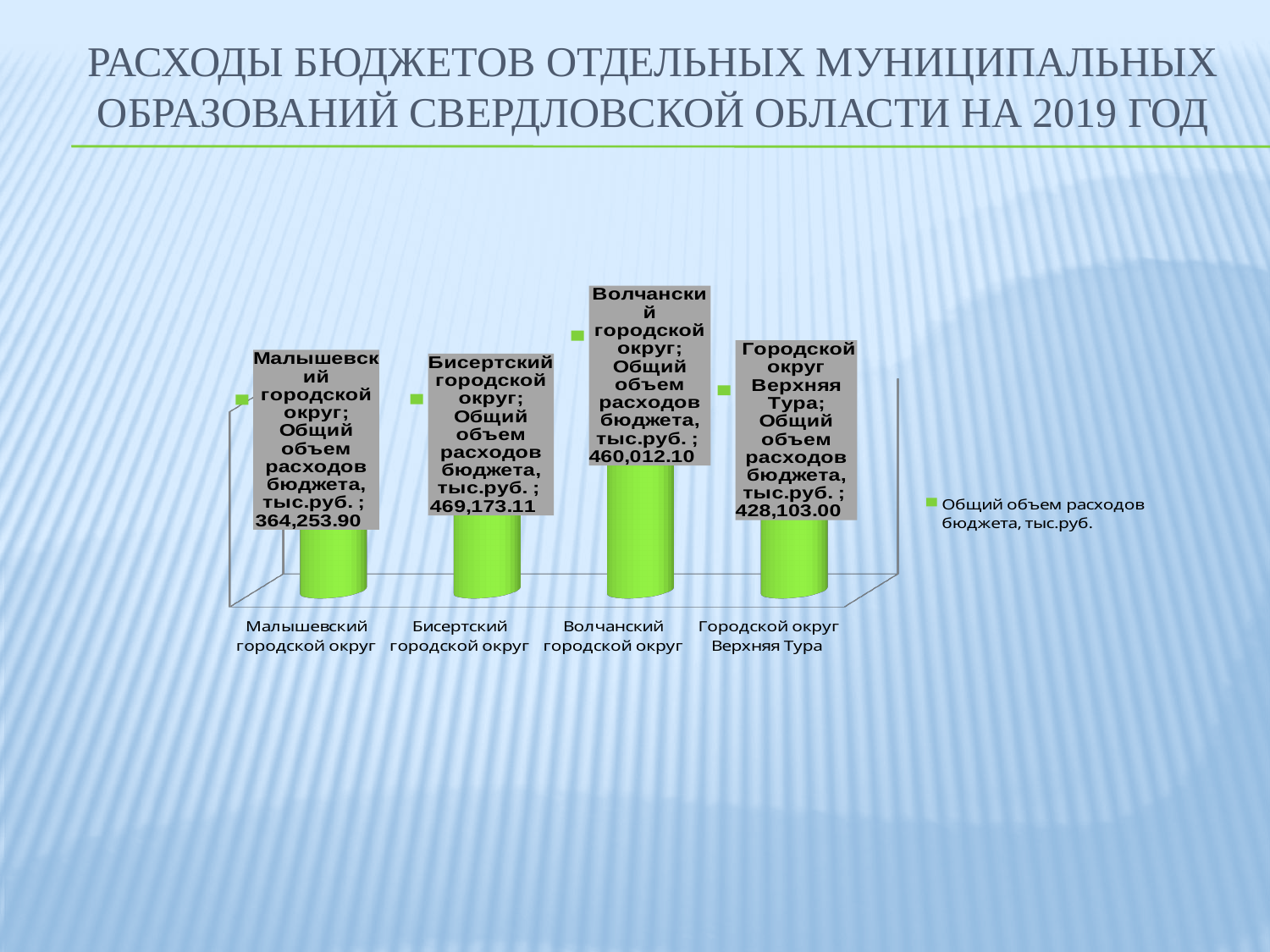
How many series does the legend list? 1 Which category has the lowest value? Малышевский городской округ What is the difference between the values for Бисертский городской округ and Малышевский городской округ? 104,919.21 What is the value for Волчанский городской округ? 460,012.10 What is the difference between the values for Городской округ Верхняя Тура and Малышевский городской округ? 63,849.10 What kind of chart is shown on the slide? Bar chart What is the value for Городской округ Верхняя Тура? 428,103.00 How many categories are shown on the chart? 4 What is the value for Бисертский городской округ? 469,173.11 What is the value for Малышевский городской округ? 364,253.90 Which is larger, the value for Городской округ Верхняя Тура or for Малышевский городской округ? Городской округ Верхняя Тура What is the legend entry of the chart? Общий объем расходов бюджета, тыс.руб.